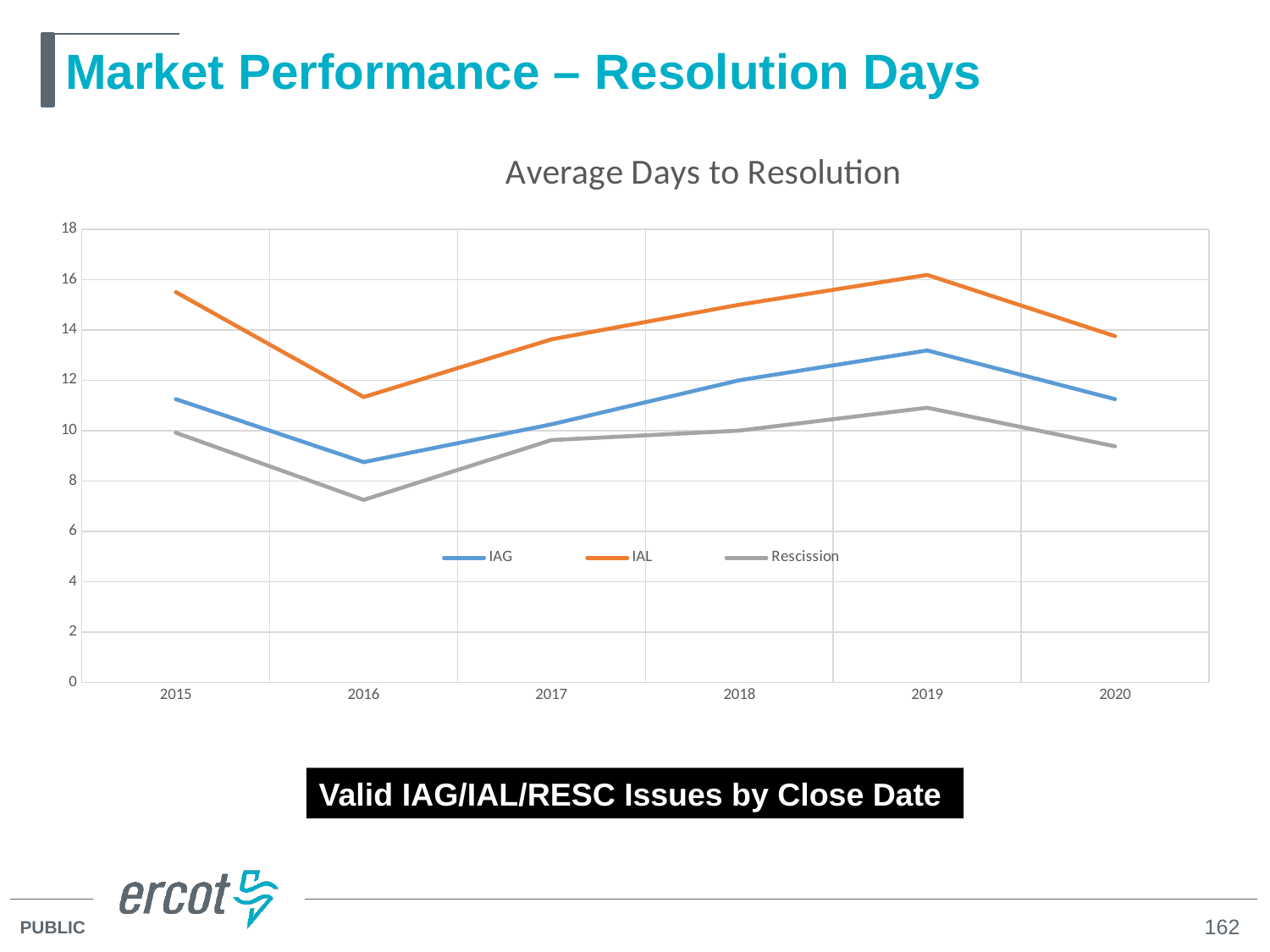
Is the value for IAL in 2015 greater or less than 14? greater How many years are shown on the x axis? 6 How many series does the legend list? 3 Which is larger in 2018, the IAG value or the Rescission value? IAG What kind of chart is shown on the slide? line chart Is the value for Rescission in 2016 greater or less than 8? less In which year is the IAL series at its lowest? 2016 In which year is the IAG series at its highest? 2019 Does the IAL series rise or fall from 2016 to 2019? rise Which series has the highest value in 2019? IAL Which series has the lowest value in 2016? Rescission What is the title of the chart? Average Days to Resolution